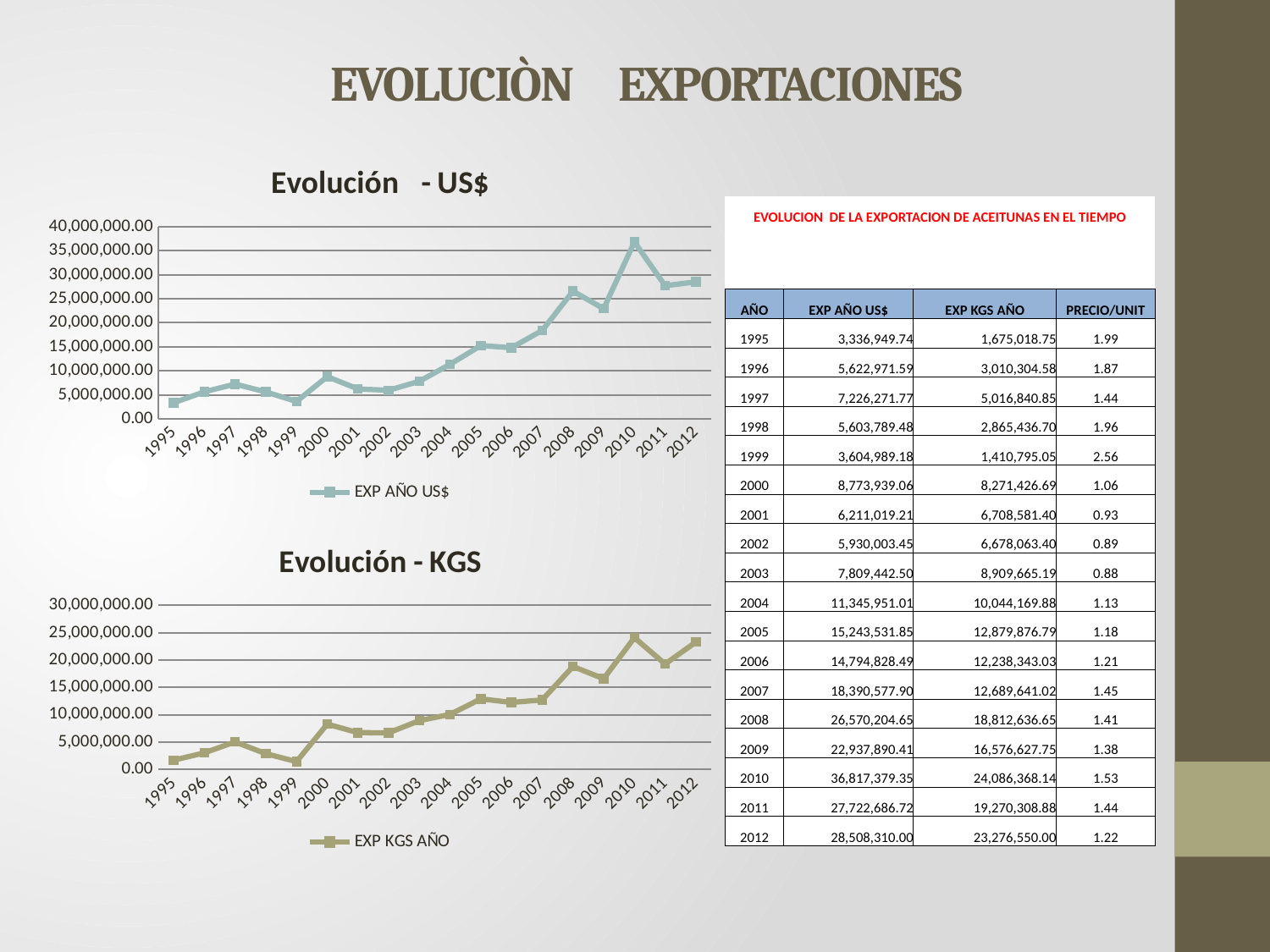
What is the legend entry shown under the "Evolución - US$" chart? EXP AÑO US$ In the "Evolución - US$" chart, which is larger, the value for 2010 or the value for 2011? 2010 What kind of chart is the "Evolución - US$" chart? line chart In the "Evolución - KGS" chart, which year has the highest value? 2010 In the "Evolución - US$" chart, is the value for 2009 greater or less than 25,000,000.00? less In the "Evolución - KGS" chart, which is larger, the value for 2008 or the value for 2009? 2008 In the "Evolución - US$" chart, which year has the highest value? 2010 How many years are plotted on the "Evolución - KGS" chart? 18 In the "Evolución - US$" chart, is the value for 2010 greater or less than 35,000,000.00? greater How many series does the legend of the "Evolución - KGS" chart list? 1 Overall, do the values in the "Evolución - US$" chart rise or fall from 1995 to 2012? rise In the "Evolución - KGS" chart, is the value for 2012 greater or less than 20,000,000.00? greater